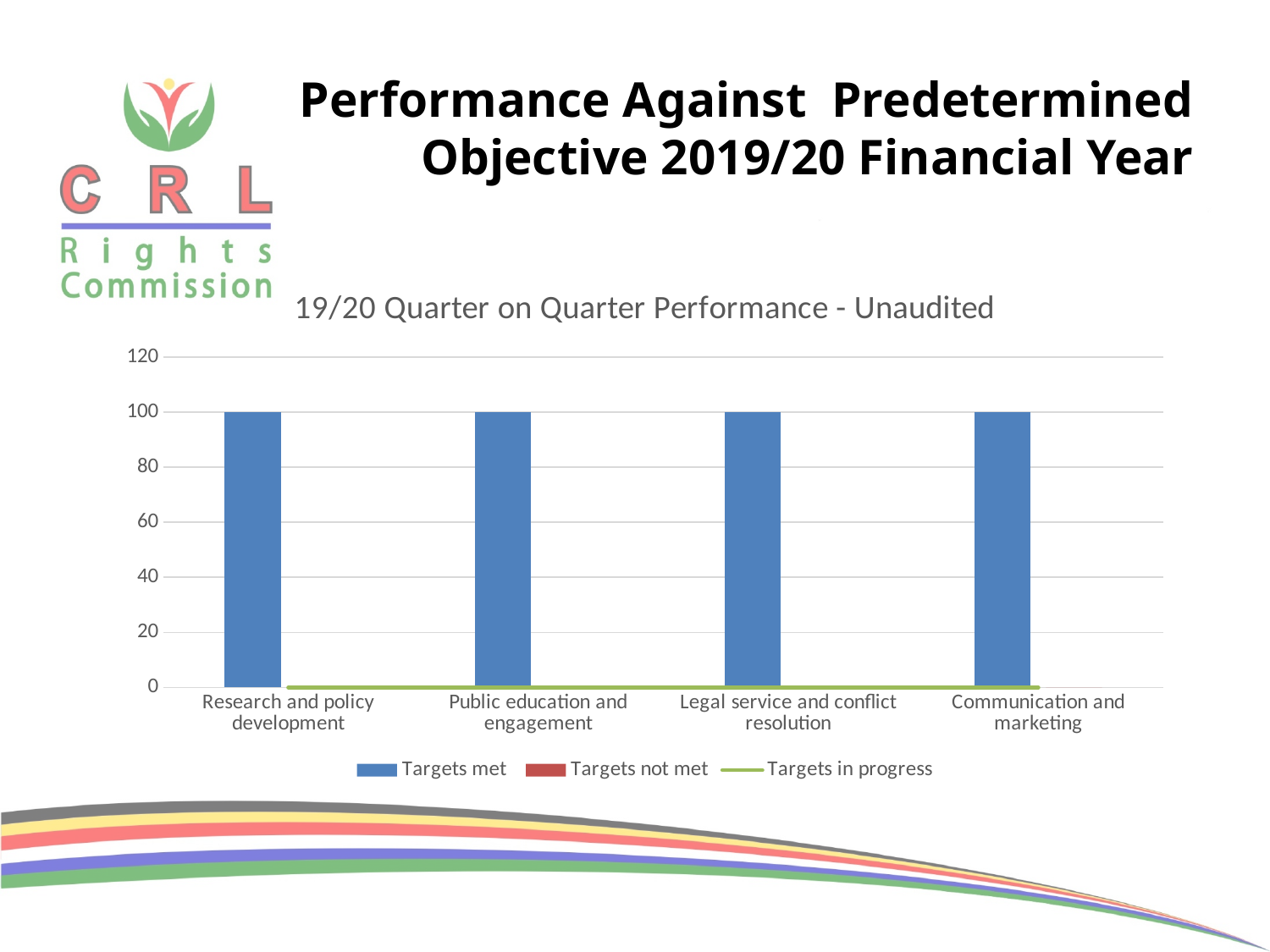
What is the value of Targets met for Legal service and conflict resolution? 100 What kind of chart is shown on the slide? Bar chart How many series does the chart's legend list? 3 What is the difference between the Targets met values for Research and policy development and Public education and engagement? 0 What is the value of Targets met for Research and policy development? 100 What is the value of Targets met for Communication and marketing? 100 Which series is shown in blue in the chart's legend? Targets met What is the title of the chart? 19/20 Quarter on Quarter Performance - Unaudited Is the Targets met value for Public education and engagement greater or less than 80? greater What is the highest value shown on the chart's vertical axis? 120 How many categories are shown on the x axis of the chart? 4 Do the Targets met values rise, fall, or stay the same across the categories on the x axis? Stay the same